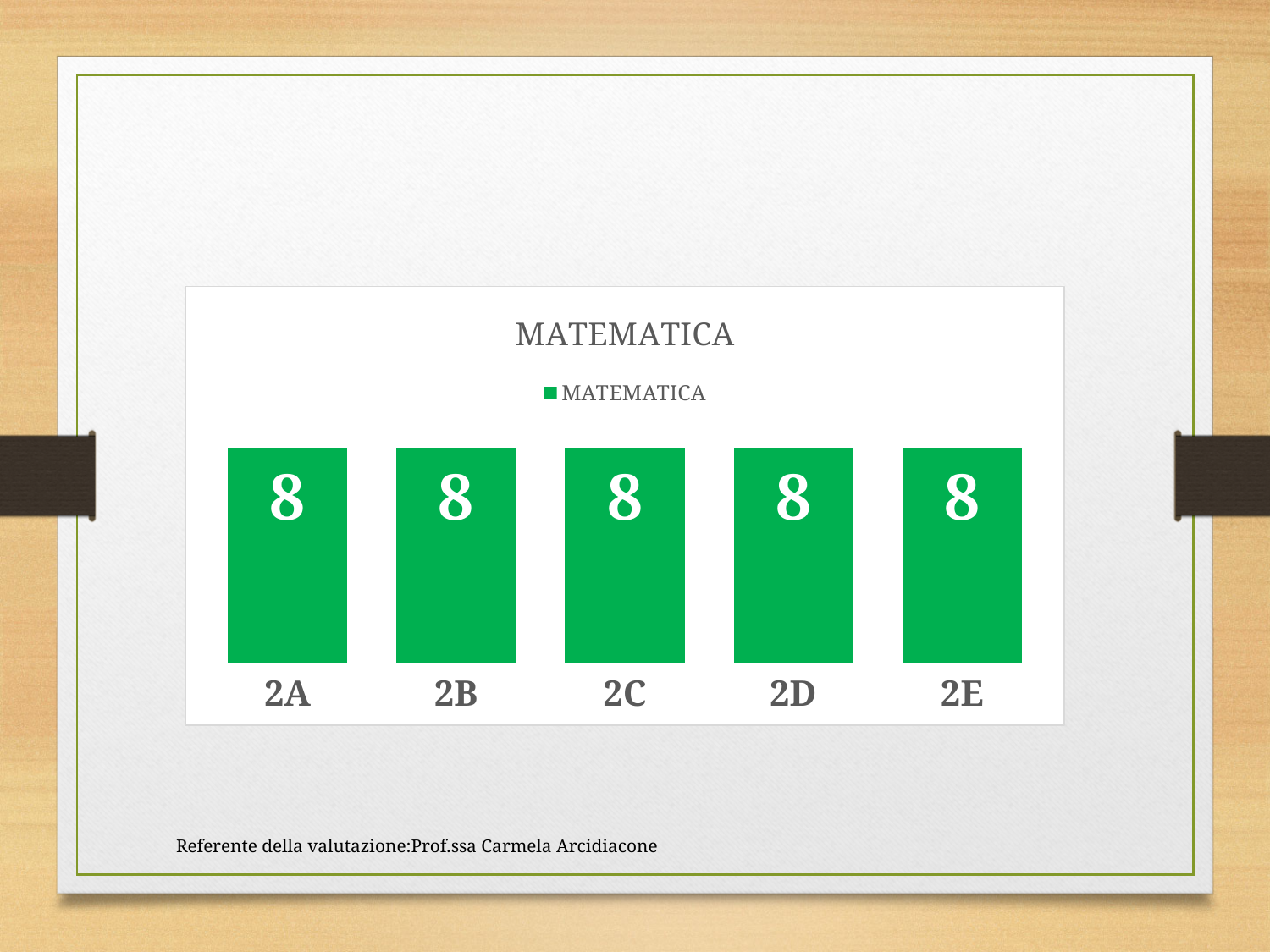
Do the values rise, fall, or stay the same from 2A to 2E? stay the same What is the value for 2E in the MATEMATICA chart? 8 How many series does the legend list? 1 How many categories are shown on the x axis of the chart? 5 What kind of chart is shown on the slide? bar chart What is the value for 2C in the MATEMATICA chart? 8 What is the value for 2A in the MATEMATICA chart? 8 Is the value for 2D larger than, smaller than, or equal to the value for 2A? equal What colour are the bars in the chart? green What is the title of the chart? MATEMATICA What is the difference between the values for 2B and 2D? 0